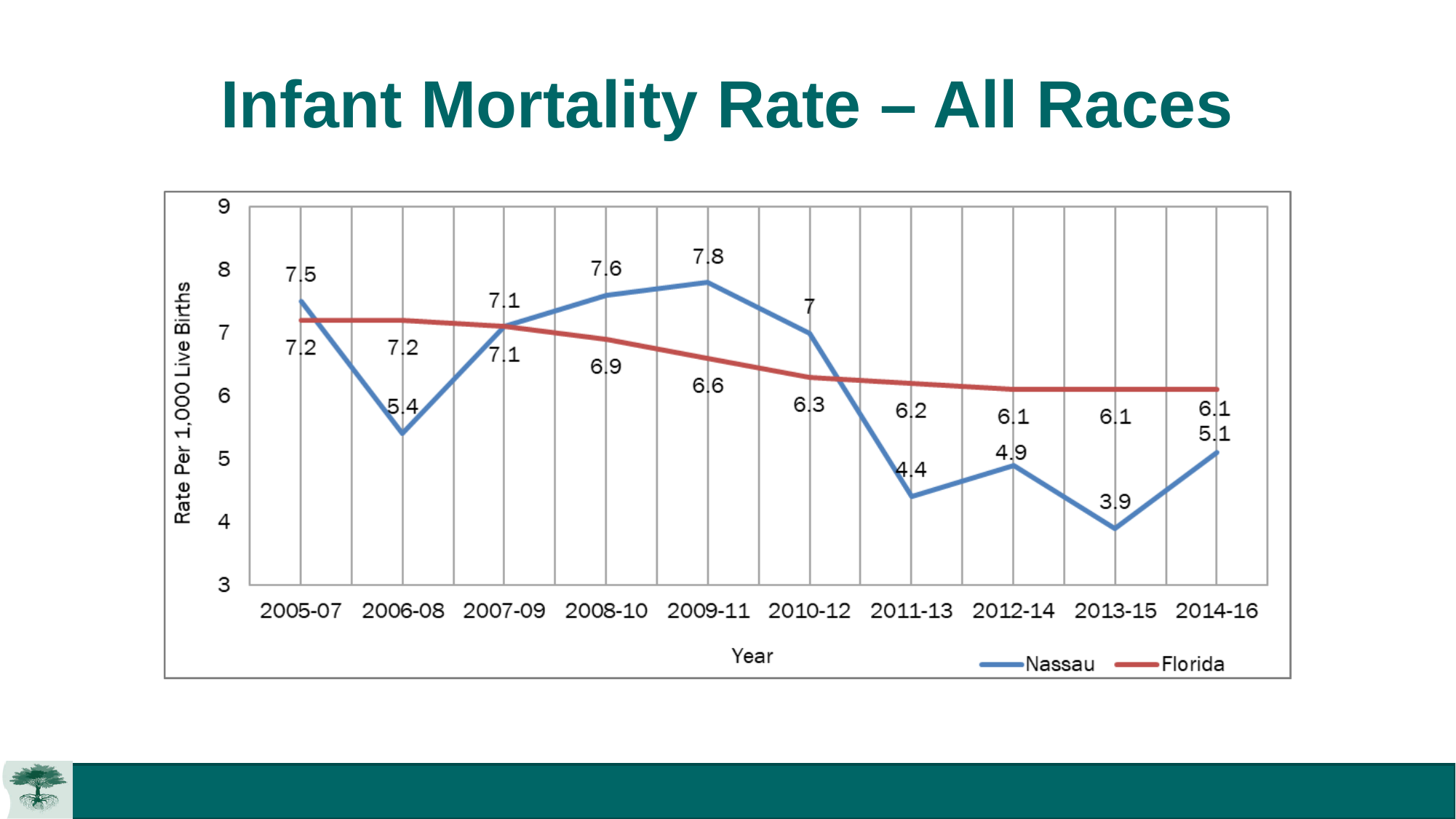
In which year period is the Nassau rate lowest? 2013-15 What is the label of the y axis? Rate Per 1,000 Live Births What is the Nassau infant mortality rate for 2009-11? 7.8 What is the difference between the Florida and Nassau rates in 2011-13? 1.8 In which year period is the Nassau rate highest? 2009-11 How many series does the legend list? 2 Does the Florida rate generally rise or fall from 2005-07 to 2014-16? Fall What is the Florida infant mortality rate for 2010-12? 6.3 What kind of chart is shown on the slide? Line chart Which is larger in 2008-10, the Nassau rate or the Florida rate? Nassau How many year periods are shown on the x axis? 10 What is the Nassau infant mortality rate for 2013-15? 3.9